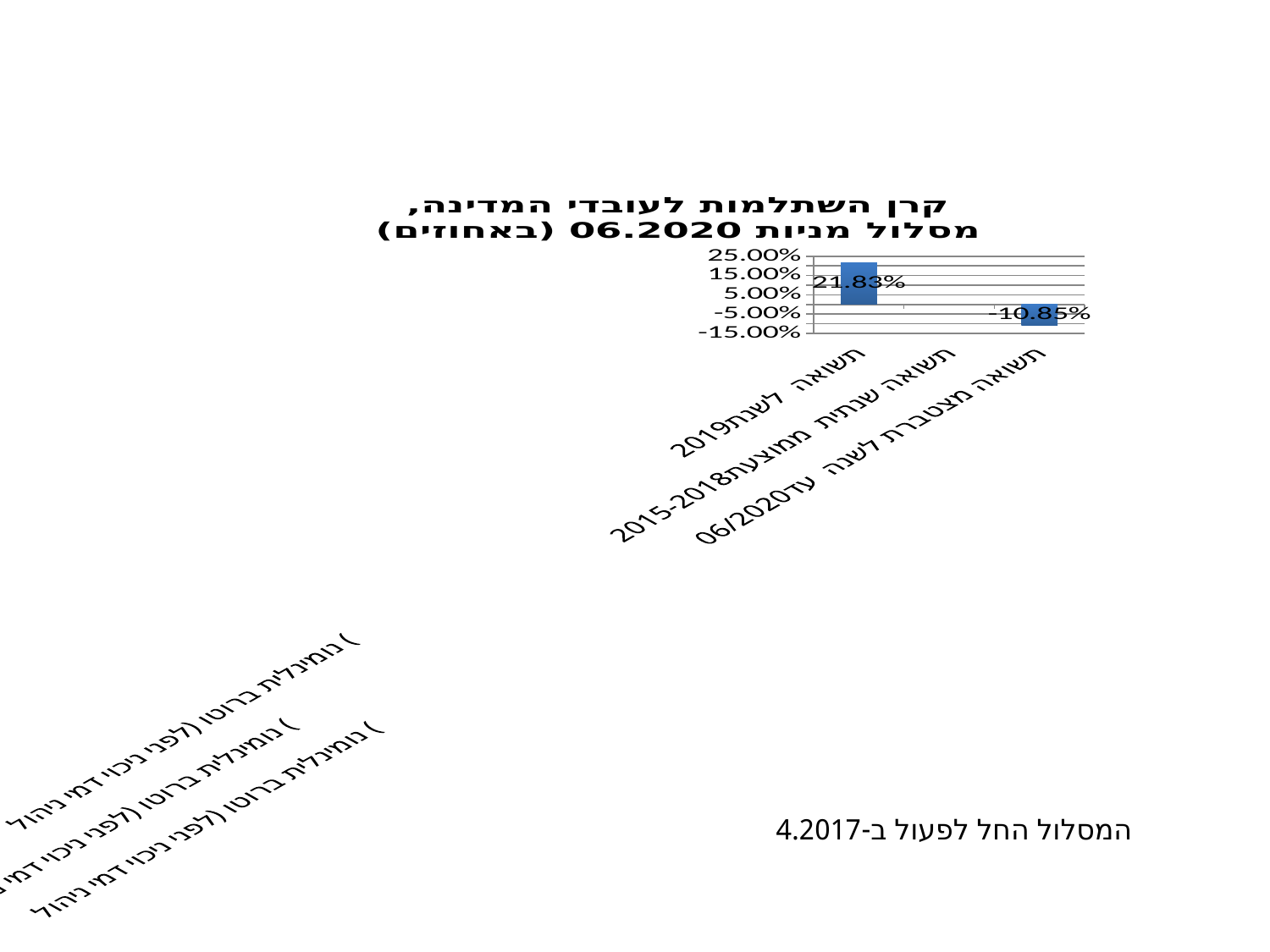
Which category has the highest value in the chart? תשואה לשנת 2019 How many categories are shown on the x axis of the chart? 3 What is the value shown for תשואה לשנת 2019? 21.83% What is the difference between the value for תשואה לשנת 2019 and the value for תשואה מצטברת לשנה עד 06/2020? 32.68 percentage points Do the plotted values rise or fall from the first category to the last category along the x axis? fall Which category has the lowest value in the chart? תשואה מצטברת לשנה עד 06/2020 Is the value for תשואה לשנת 2019 greater or less than 15.00%? greater What is the highest value labelled on the vertical axis of the chart? 25.00% Which is larger: the value for תשואה לשנת 2019 or the value for תשואה מצטברת לשנה עד 06/2020? תשואה לשנת 2019 What is the value shown for תשואה מצטברת לשנה עד 06/2020? -10.85% Is the value for תשואה מצטברת לשנה עד 06/2020 greater or less than -5.00%? less What kind of chart is shown on the slide? bar chart